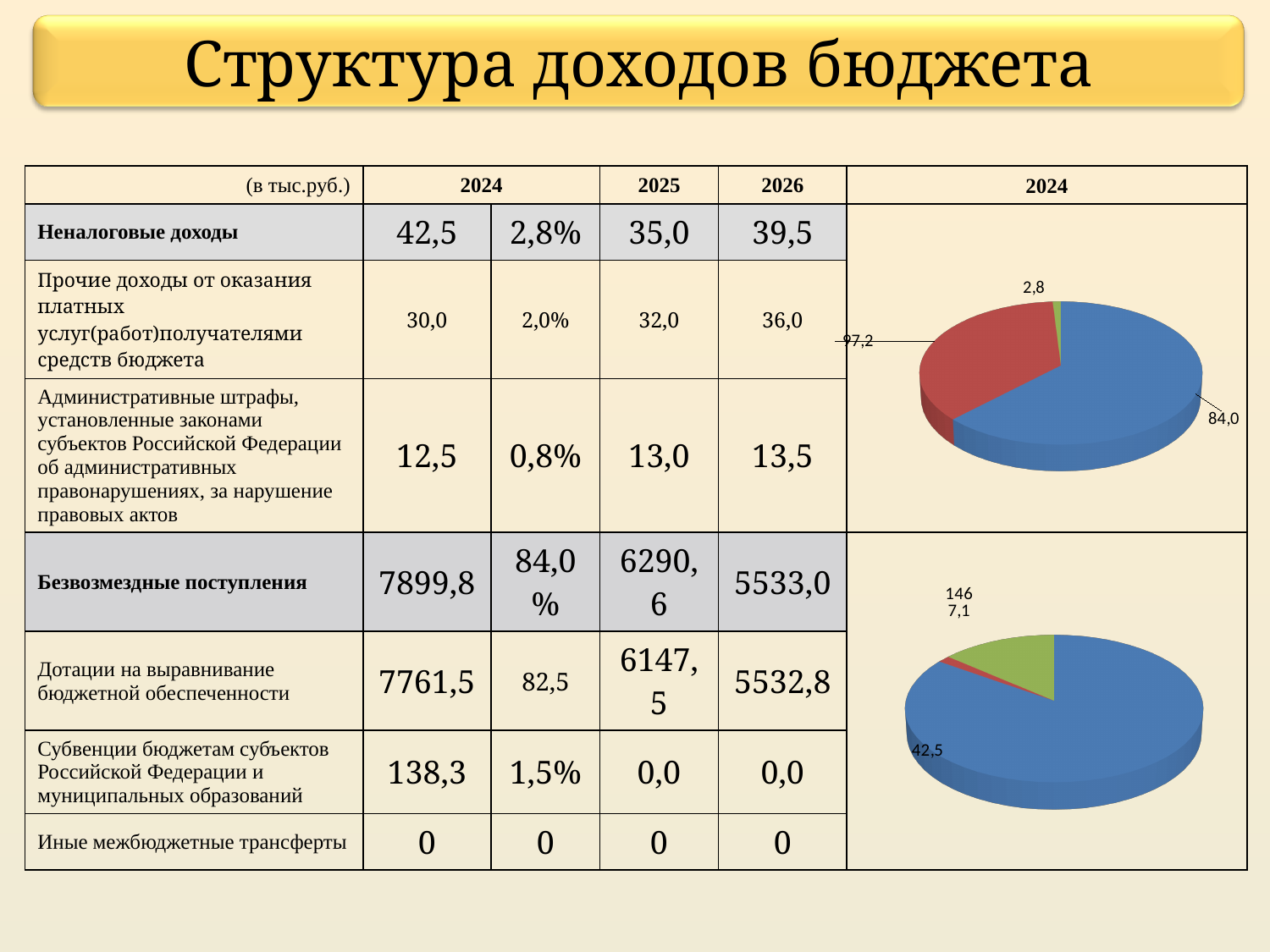
In the upper pie chart, what data label is shown next to the blue slice? 84,0 What kind of chart is the upper chart on the right side of the slide? pie chart In the upper pie chart, how many slices are there? 3 In the upper pie chart, which colour slice is the smallest? green In the lower pie chart, how many slices are there? 3 In the lower pie chart, which colour slice is the smallest? red In the upper pie chart, which colour slice is the largest? blue In the lower pie chart, what data label is shown next to the blue slice? 42,5 What kind of chart is the lower chart on the right side of the slide? pie chart In the upper pie chart, what data label is shown next to the small green slice? 2,8 In the lower pie chart, which colour slice is the largest? blue In the lower pie chart, is the green slice larger or smaller than the red slice? larger